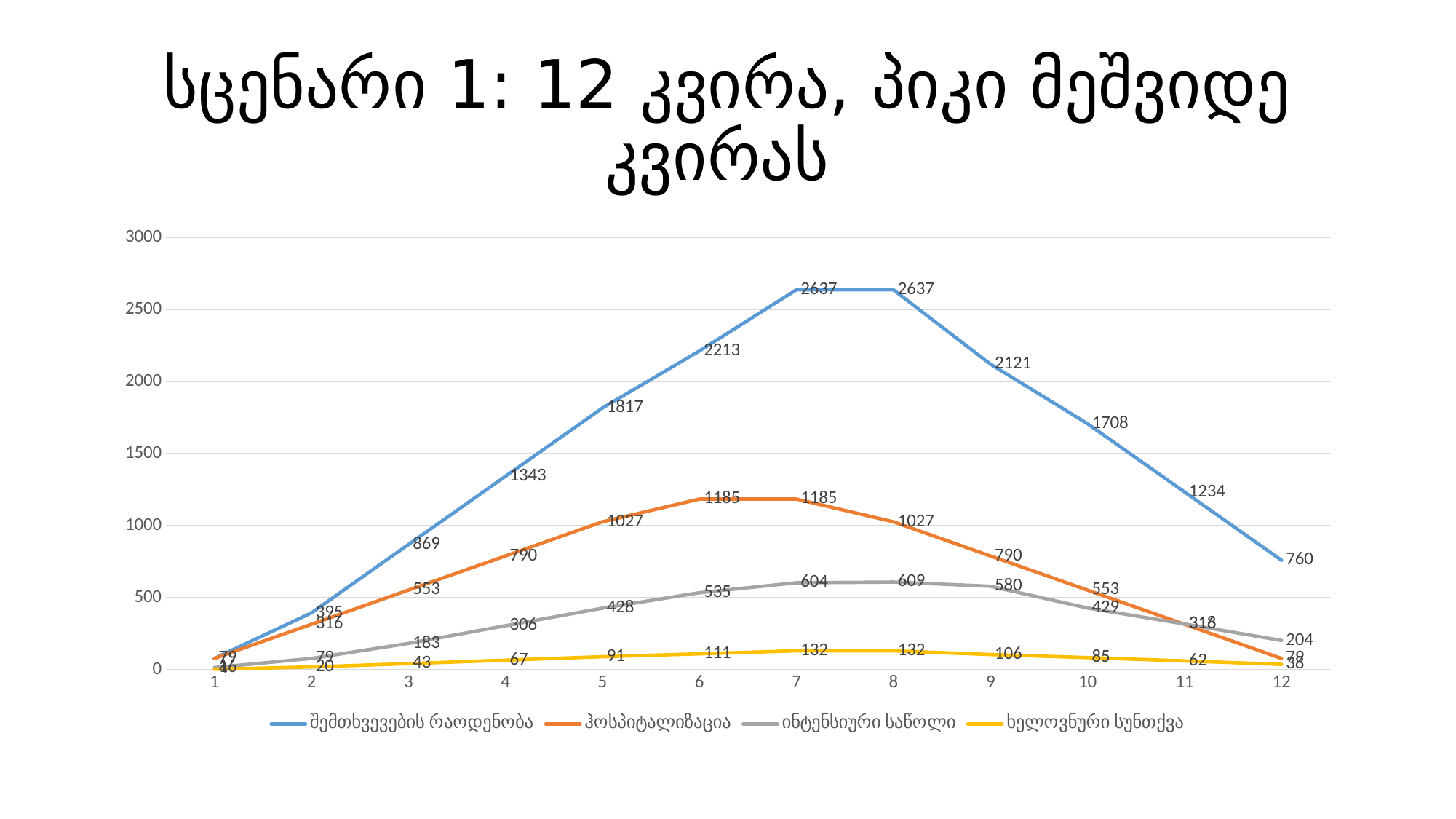
Which is larger: ჰოსპიტალიზაცია at week 4 or ინტენსიური საწოლი at week 7? ჰოსპიტალიზაცია at week 4 What type of chart is shown on the slide? line chart How many series does the legend list? 4 How many weeks (x-axis points) are plotted on the chart? 12 What is the difference between შემთხვევების რაოდენობა at week 6 and at week 5? 396 Which series is drawn in yellow? ხელოვნური სუნთქვა What is the value of ინტენსიური საწოლი at week 8? 609 What is the value of ხელოვნური სუნთქვა at week 9? 106 What is the value of შემთხვევების რაოდენობა at week 7? 2637 What is the value of ჰოსპიტალიზაცია at week 5? 1027 Does შემთხვევების რაოდენობა rise or fall from week 8 to week 12? fall At which week does ინტენსიური საწოლი reach its highest value? 8